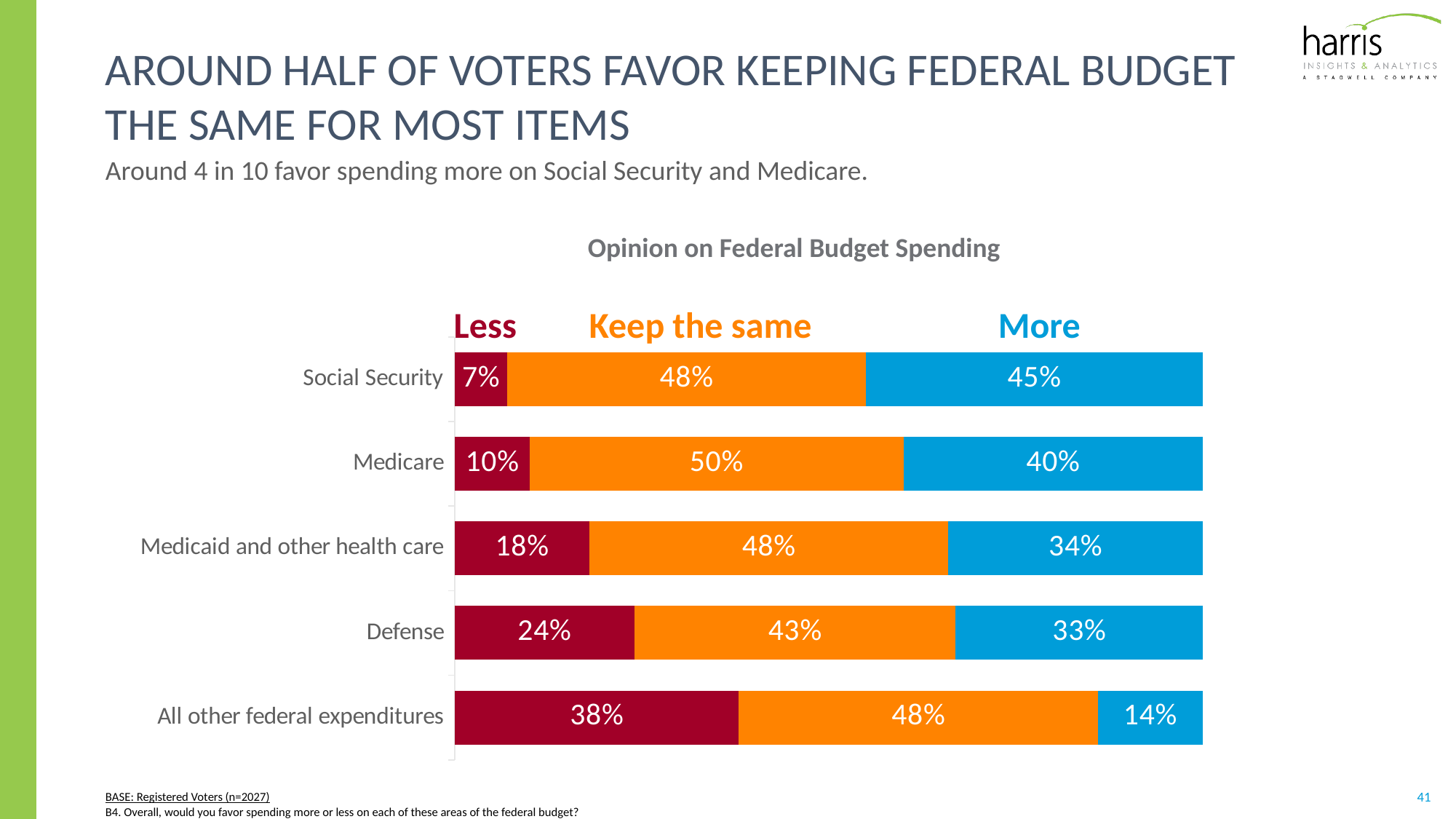
Which category has the highest share of voters favoring spending less? All other federal expenditures Which is larger: the 'Less' percentage for Medicaid and other health care or the 'Less' percentage for Defense? Defense How many series (response options) does the chart show? 3 What is the difference between the 'More' percentages for Social Security and Medicare? 5% What percentage of voters favor keeping spending the same on Medicare? 50% Which category has the lowest share of voters favoring spending more? All other federal expenditures How many budget categories are shown in the chart? 5 What is the total of the three segments for the Defense bar? 100% What percentage of voters favor spending less on Defense? 24% What percentage of voters favor spending more on Social Security? 45% What kind of chart is shown on the slide? Stacked bar chart What is the title of the chart? Opinion on Federal Budget Spending